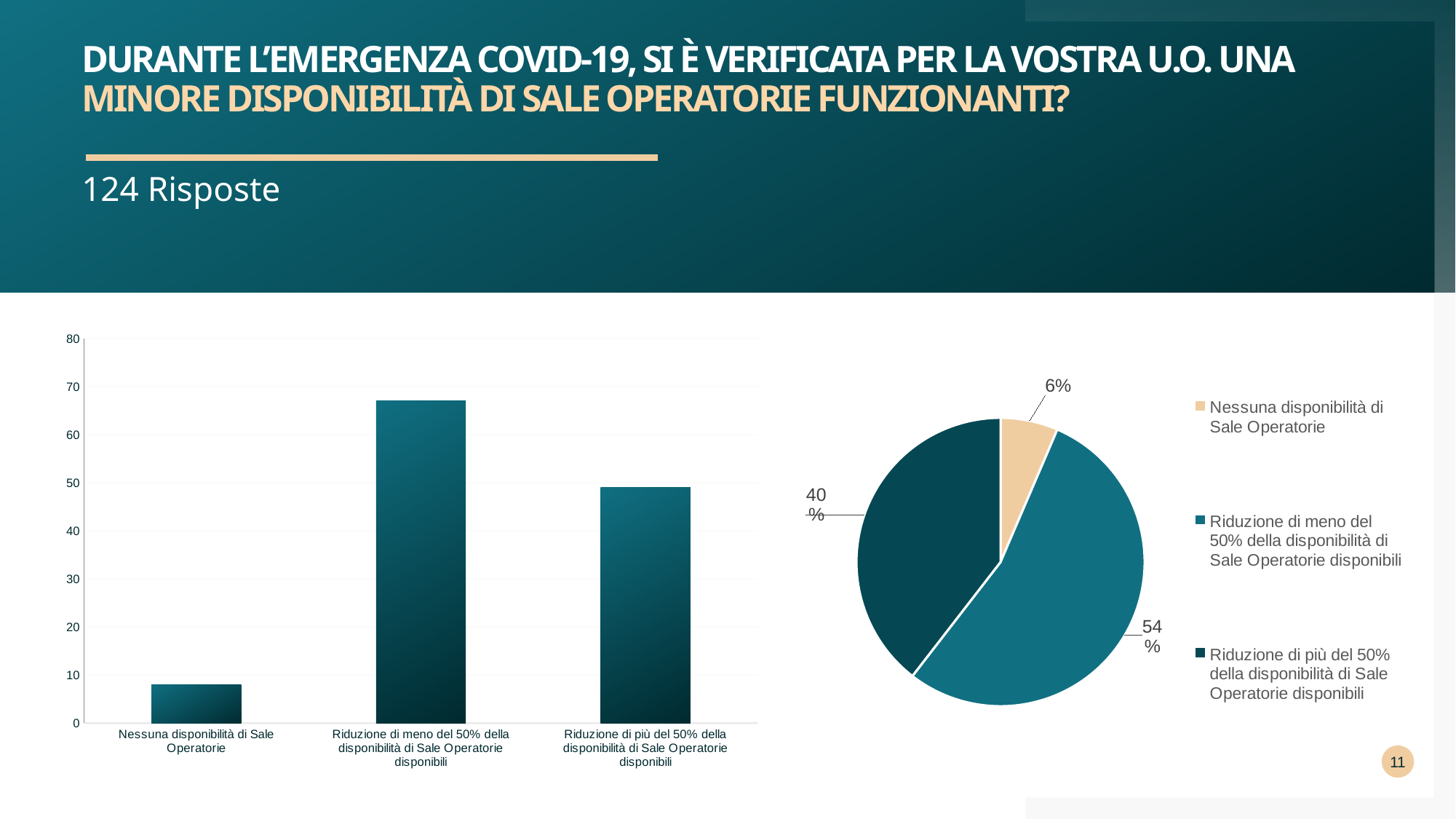
What kind of chart is on the left side of the slide? bar chart How many categories are shown in the bar chart on the left? 3 In the pie chart on the right, what share is shown for 'Riduzione di meno del 50% della disponibilità di Sale Operatorie disponibili'? 54% In the bar chart on the left, is the value for 'Nessuna disponibilità di Sale Operatorie' greater or less than 10? less In the bar chart on the left, is the value for 'Riduzione di più del 50% della disponibilità di Sale Operatorie disponibili' greater or less than 40? greater In the pie chart on the right, which slice is the smallest? Nessuna disponibilità di Sale Operatorie In the bar chart on the left, is the value for 'Riduzione di meno del 50% della disponibilità di Sale Operatorie disponibili' greater or less than 60? greater In the pie chart on the right, what is the difference between the share for 'Riduzione di meno del 50%' and the share for 'Riduzione di più del 50%'? 14% How many entries does the legend of the pie chart on the right list? 3 In the bar chart on the left, which category has the lowest bar? Nessuna disponibilità di Sale Operatorie In the pie chart on the right, what share is shown for 'Nessuna disponibilità di Sale Operatorie'? 6% In the bar chart on the left, which category has the highest bar? Riduzione di meno del 50% della disponibilità di Sale Operatorie disponibili